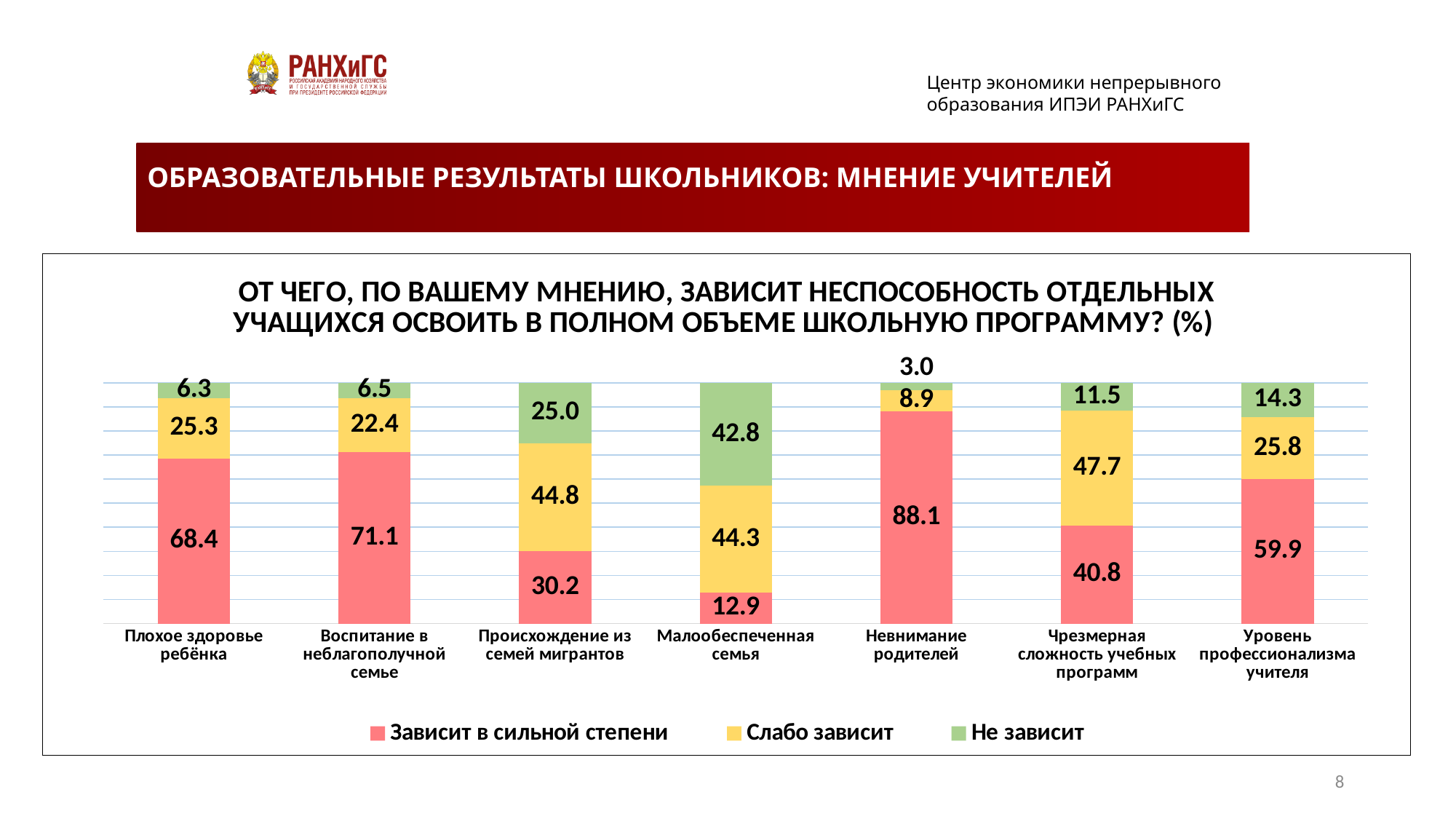
What is the value of "Слабо зависит" for "Чрезмерная сложность учебных программ"? 47.7 Which category has the highest value for "Зависит в сильной степени"? Невнимание родителей Which category has the lowest value for "Зависит в сильной степени"? Малообеспеченная семья Which is larger: the "Не зависит" value for "Происхождение из семей мигрантов" or for "Уровень профессионализма учителя"? Происхождение из семей мигрантов What is the value of "Зависит в сильной степени" for "Невнимание родителей"? 88.1 What is the difference between the "Зависит в сильной степени" values for "Невнимание родителей" and "Малообеспеченная семья"? 75.2 How many series does the legend list? 3 How many categories are shown on the x axis? 7 What is the total of the stacked bar for "Плохое здоровье ребёнка"? 100.0 What is the value of "Не зависит" for "Малообеспеченная семья"? 42.8 Which colour represents the series "Не зависит" in the legend? Green What kind of chart is shown on the slide? Stacked bar chart